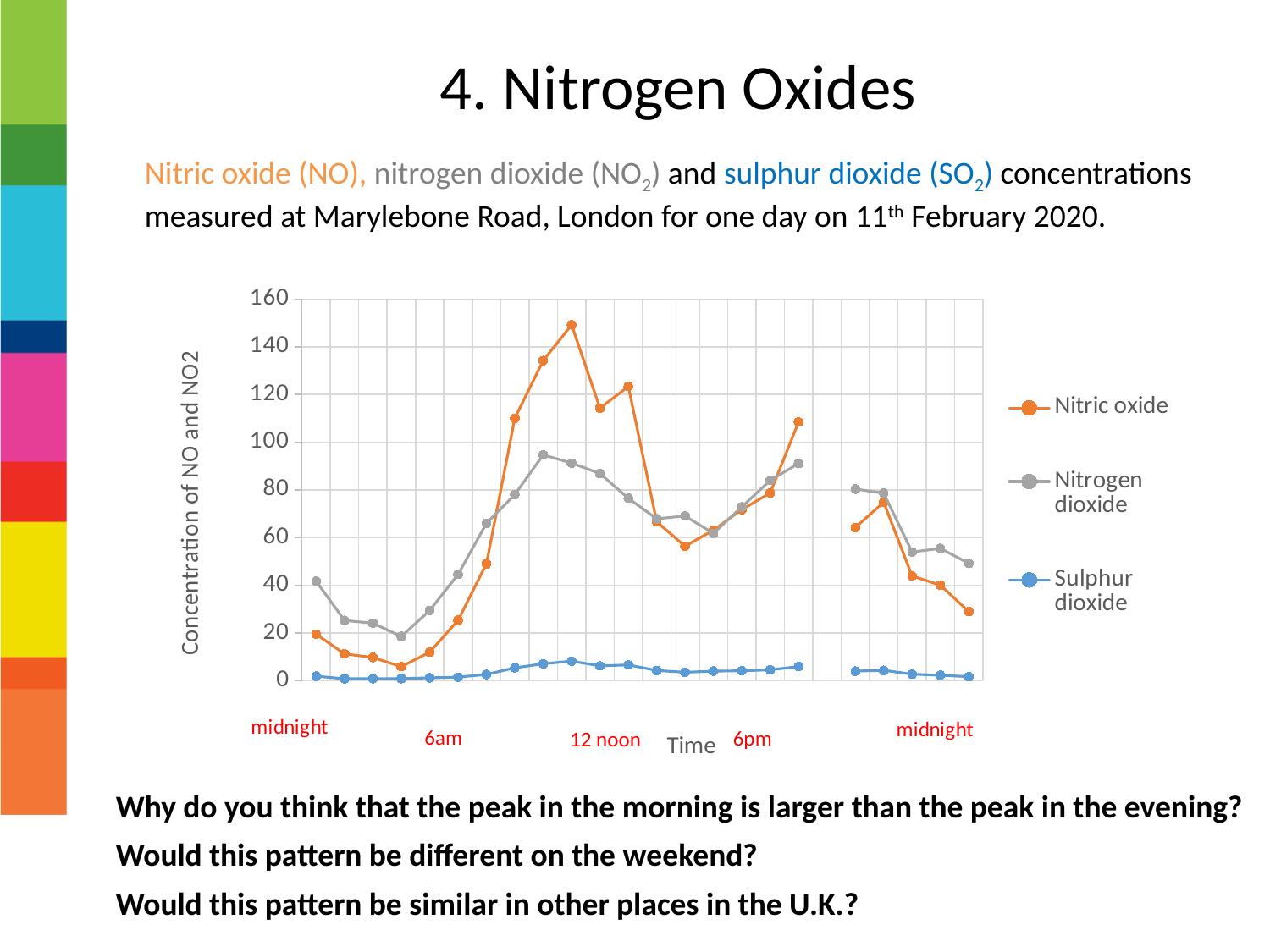
How many series does the chart's legend list? 3 Is the highest value reached by Nitrogen dioxide greater or less than 100? less What is the title of the vertical axis of the chart? Concentration of NO and NO2 What is the title of the horizontal axis of the chart? Time Which series reaches the highest value on the chart? Nitric oxide Between 6am and the morning peak, does the Nitric oxide line rise or fall? rise Which series has the lowest values throughout the day? Sulphur dioxide Is the value for Nitrogen dioxide at the first midnight greater or less than 60? less At the first midnight, which is higher, Nitric oxide or Nitrogen dioxide? Nitrogen dioxide Is the value for Sulphur dioxide at 12 noon greater or less than 20? less What kind of chart is shown on the slide? line chart